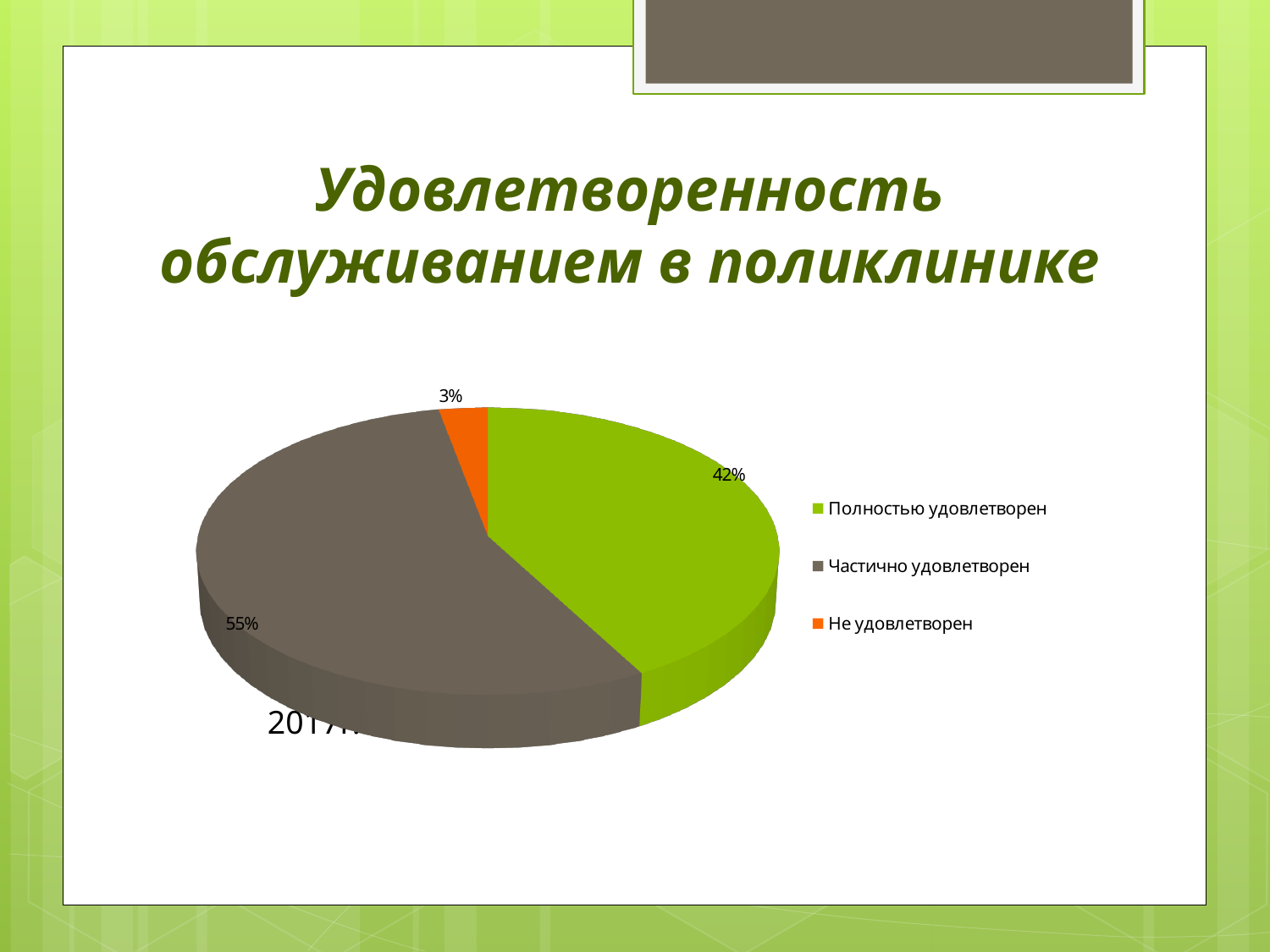
What is the title of the slide containing the chart? Удовлетворенность обслуживанием в поликлинике What share of the pie is labelled "Полностью удовлетворен"? 42% How many entries does the legend list? 3 What kind of chart is shown on the slide? pie chart Which category has the smallest slice of the pie? Не удовлетворен What colour is the slice for "Не удовлетворен"? orange Which is larger: the share for "Полностью удовлетворен" or the share for "Не удовлетворен"? Полностью удовлетворен What share of the pie is labelled "Не удовлетворен"? 3% What share of the pie is labelled "Частично удовлетворен"? 55% Which category has the largest slice of the pie? Частично удовлетворен How many slices does the pie chart have? 3 What is the difference in percentage points between "Частично удовлетворен" and "Полностью удовлетворен"? 13